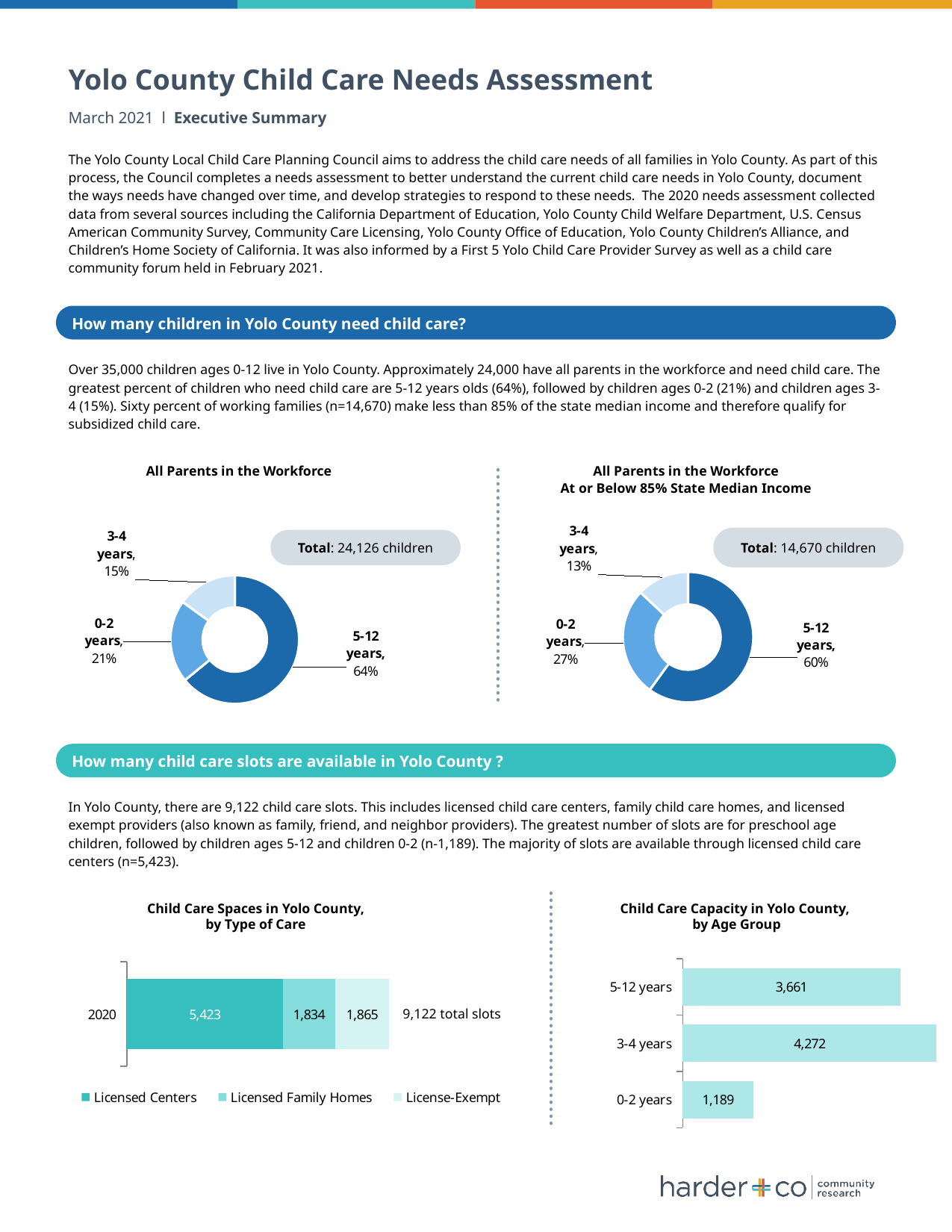
In the 'Child Care Capacity in Yolo County, by Age Group' chart, which age group has the highest capacity? 3-4 years In the 'All Parents in the Workforce' donut chart, which age group has the smallest share? 3-4 years In the 'Child Care Spaces in Yolo County, by Type of Care' chart, how many series does the legend list? 3 In the 'All Parents in the Workforce At or Below 85% State Median Income' donut chart, what share of children are 0-2 years old? 27% In the 'Child Care Capacity in Yolo County, by Age Group' chart, what is the difference between the 3-4 years and 5-12 years values? 611 What kind of chart is 'Child Care Capacity in Yolo County, by Age Group'? Bar chart In the 'Child Care Spaces in Yolo County, by Type of Care' chart, what is the total of the stacked bar? 9,122 total slots In the 'All Parents in the Workforce At or Below 85% State Median Income' donut chart, what is the difference in percentage points between the 5-12 years and 3-4 years shares? 47 percentage points In the 'All Parents in the Workforce' donut chart, what is the total number of children shown? 24,126 children In the 'All Parents in the Workforce At or Below 85% State Median Income' donut chart, how many age groups are shown? 3 In the 'All Parents in the Workforce' donut chart, what share of children are 5-12 years old? 64% In the 'Child Care Spaces in Yolo County, by Type of Care' chart, what is the value for Licensed Centers? 5,423